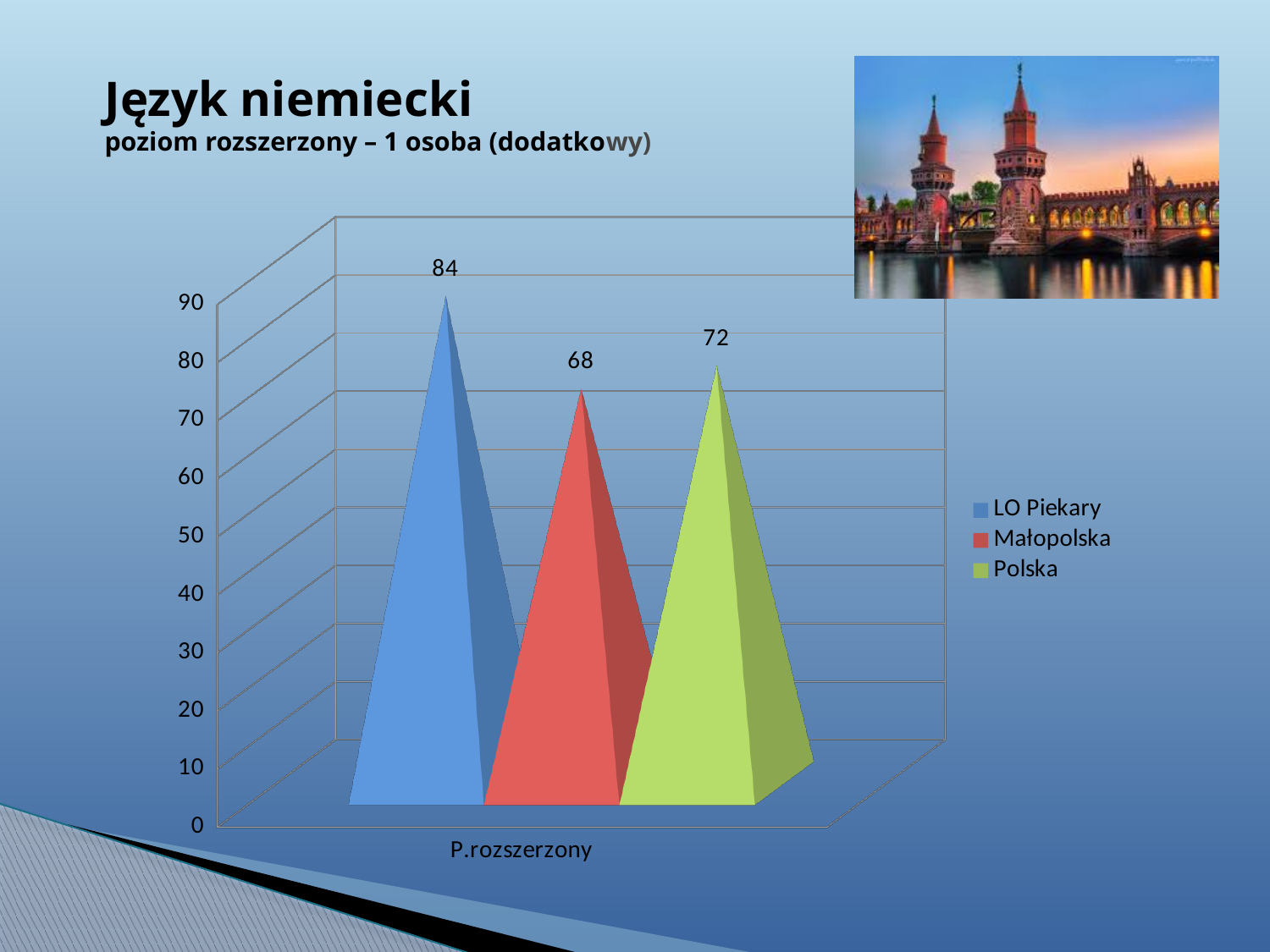
Is the value for Małopolska greater or less than 70? less Which series has the lowest value in the P.rozszerzony category? Małopolska What colour represents Polska in the chart? Green What is the difference between the Polska value and the Małopolska value? 4 Which series has the highest value in the P.rozszerzony category? LO Piekary What is the value for Małopolska in the P.rozszerzony category? 68 Which is larger, the value for LO Piekary or the value for Polska? LO Piekary How many categories are shown on the x axis? 1 How many series does the legend list? 3 What is the value for LO Piekary in the P.rozszerzony category? 84 What is the difference between the LO Piekary value and the Małopolska value? 16 What is the value for Polska in the P.rozszerzony category? 72